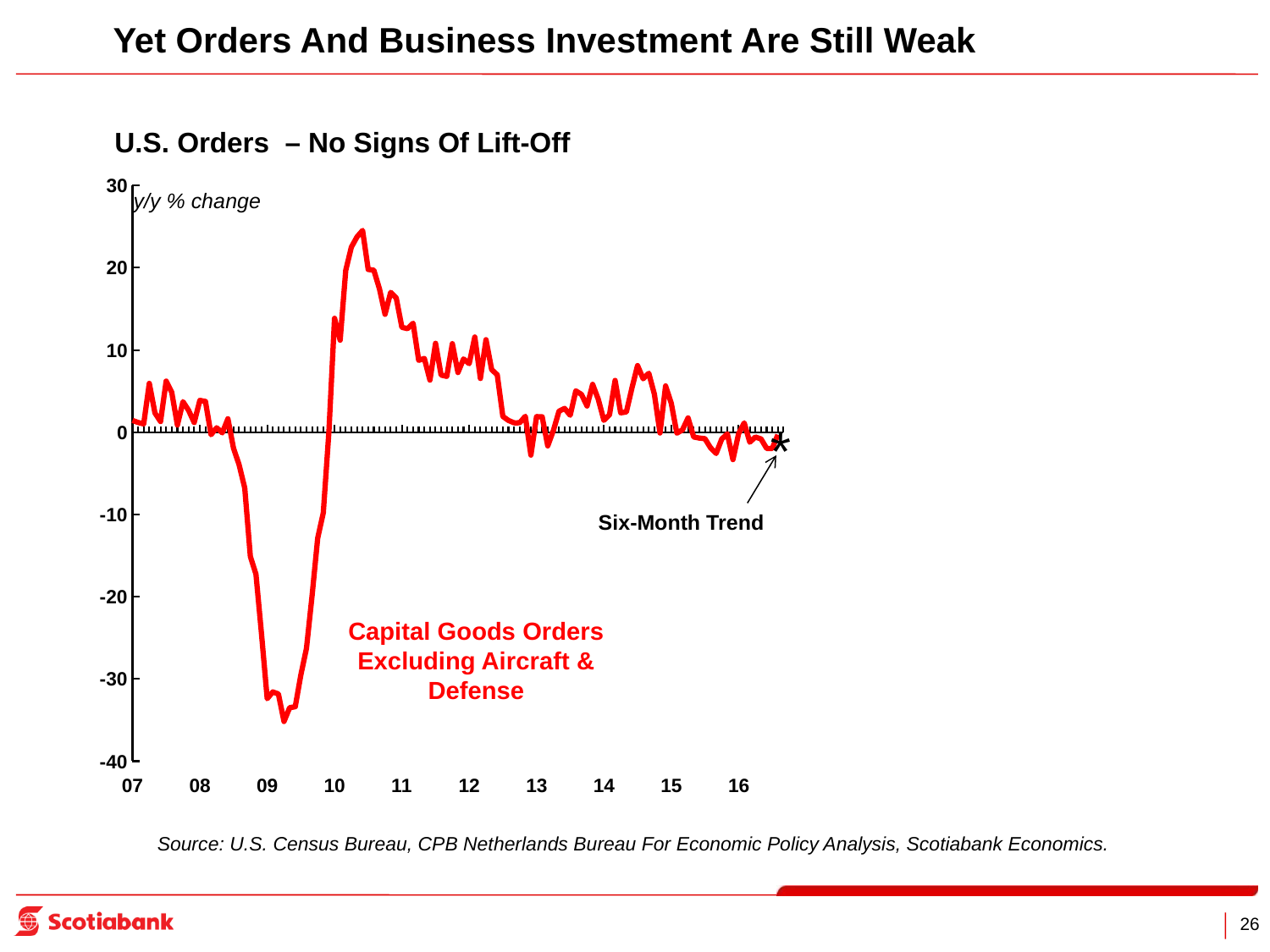
What kind of chart is shown on the slide? line chart How many year labels are shown on the x axis? 10 What is the title of the chart? U.S. Orders – No Signs Of Lift-Off Is the value of the line at the end of 2016 greater or less than 10? less In which year does the line reach its lowest point? 09 Is the highest value of the line, reached in 2010, greater or less than 20? greater In which year does the line reach its highest point? 10 Does the line generally rise or fall between the start of 2009 and the middle of 2010? rise Is the value of the line at the start of 2012 greater or less than 0? greater Does the line generally rise or fall between the middle of 2010 and the end of 2012? fall What unit is the y axis of the chart measured in, according to the label at the top of the axis? y/y % change